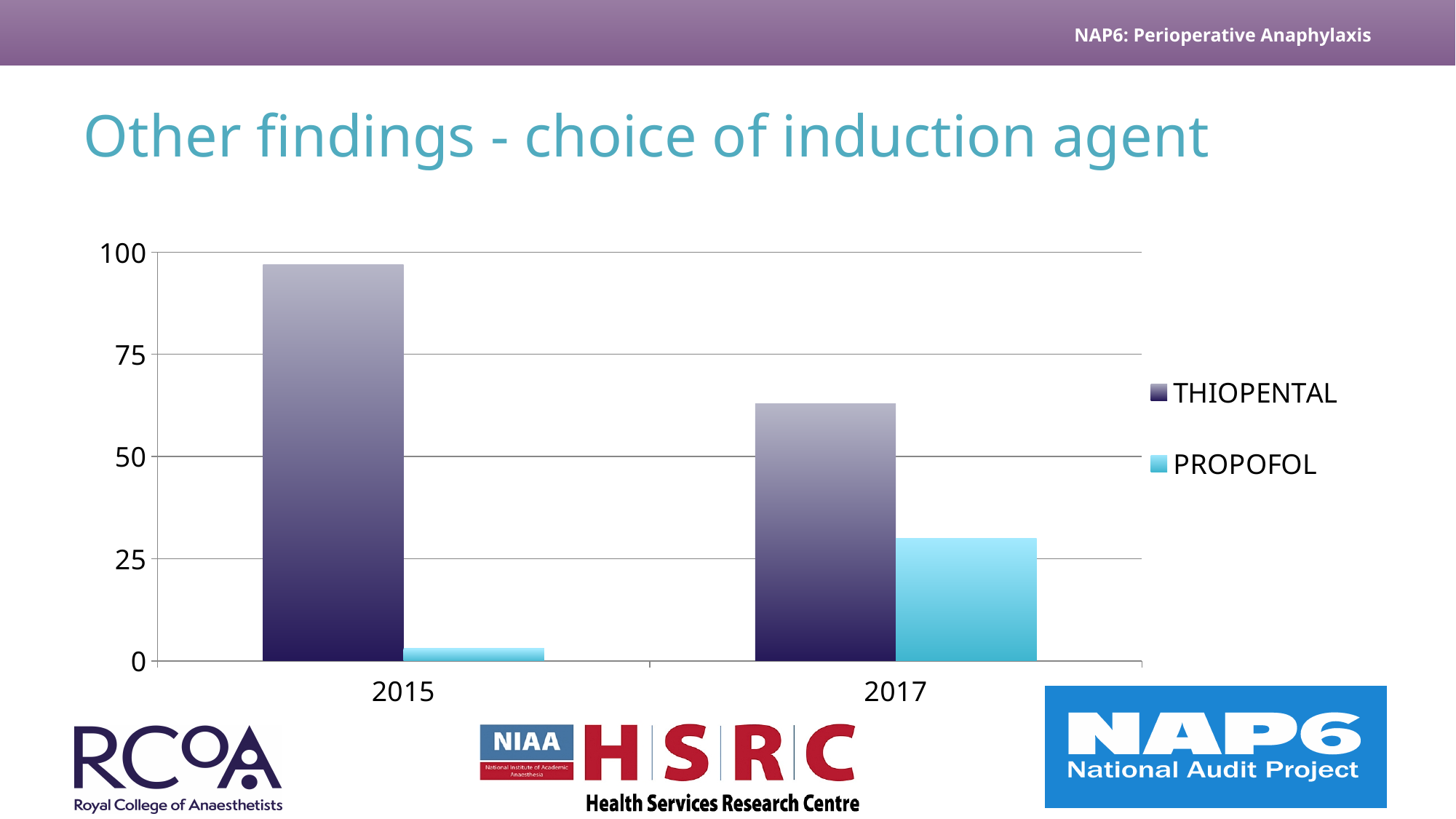
Which is larger in 2017, THIOPENTAL or PROPOFOL? THIOPENTAL Is the value for PROPOFOL in 2017 greater or less than 25? greater Is the value for PROPOFOL in 2015 greater or less than 25? less Which bar is the lowest on the chart? PROPOFOL in 2015 Is the value for THIOPENTAL in 2015 greater or less than 75? greater How many year categories are shown on the x axis? 2 Does the value for THIOPENTAL rise or fall from 2015 to 2017? fall How many series does the legend list? 2 Which series has the highest bar on the chart? THIOPENTAL Does the value for PROPOFOL rise or fall from 2015 to 2017? rise What kind of chart is shown on the slide? bar chart